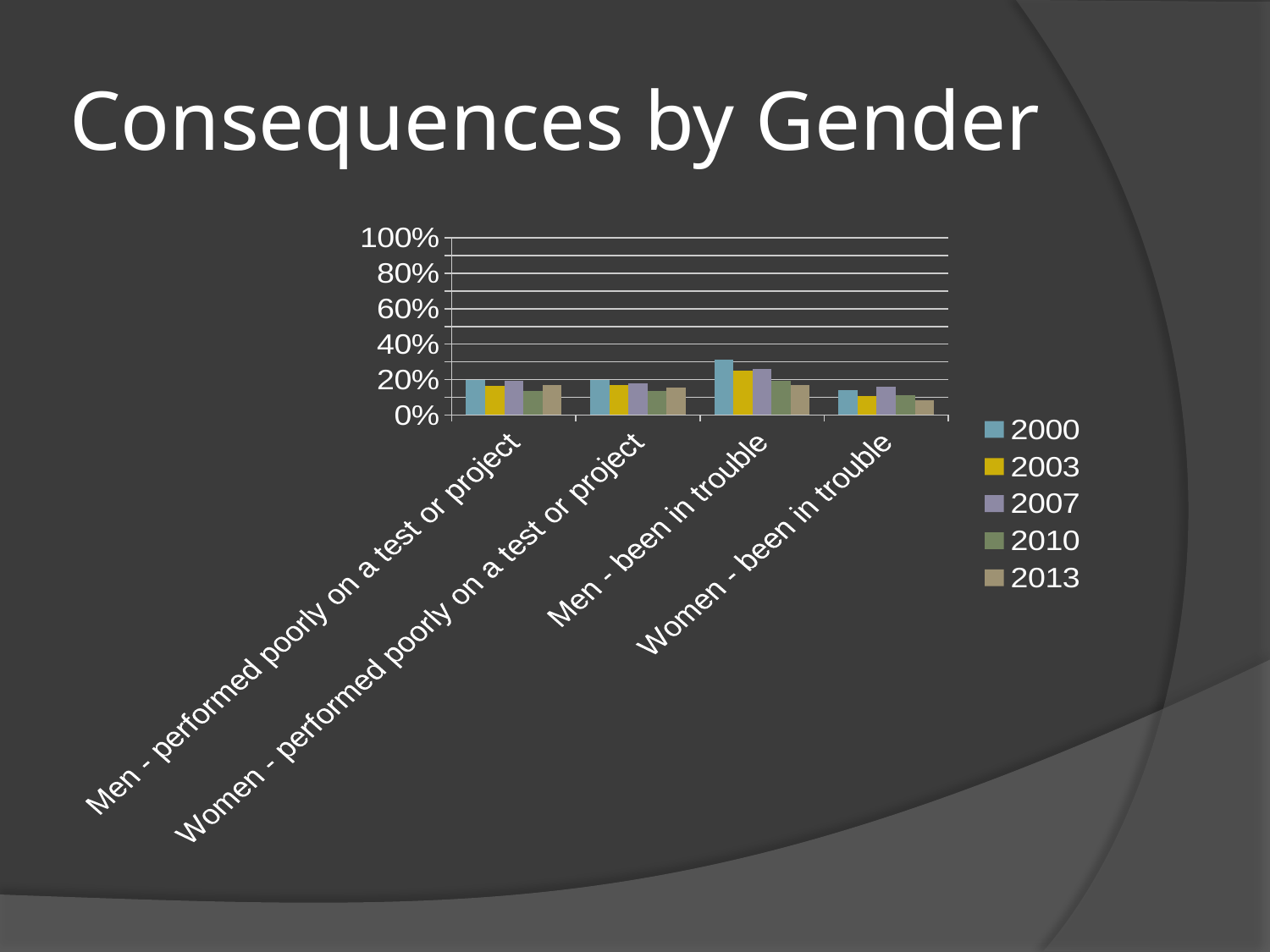
What is the title of the slide containing the chart? Consequences by Gender Which series has the lowest value in the Women - been in trouble category? 2013 Is the 2013 value for Women - been in trouble greater or less than 20%? less For Men - been in trouble, which is larger: the 2000 value or the 2013 value? 2000 How many series does the chart's legend list? 5 What kind of chart is shown on the slide? bar chart Which category has the tallest bar in the chart? Men - been in trouble For the year 2000, which is larger: Men - been in trouble or Women - been in trouble? Men - been in trouble Is the 2000 value for Men - been in trouble greater or less than 20%? greater Which years are listed in the chart's legend? 2000, 2003, 2007, 2010, 2013 How many categories are shown on the x axis of the chart? 4 Is the 2000 value for Men - performed poorly on a test or project greater or less than 40%? less